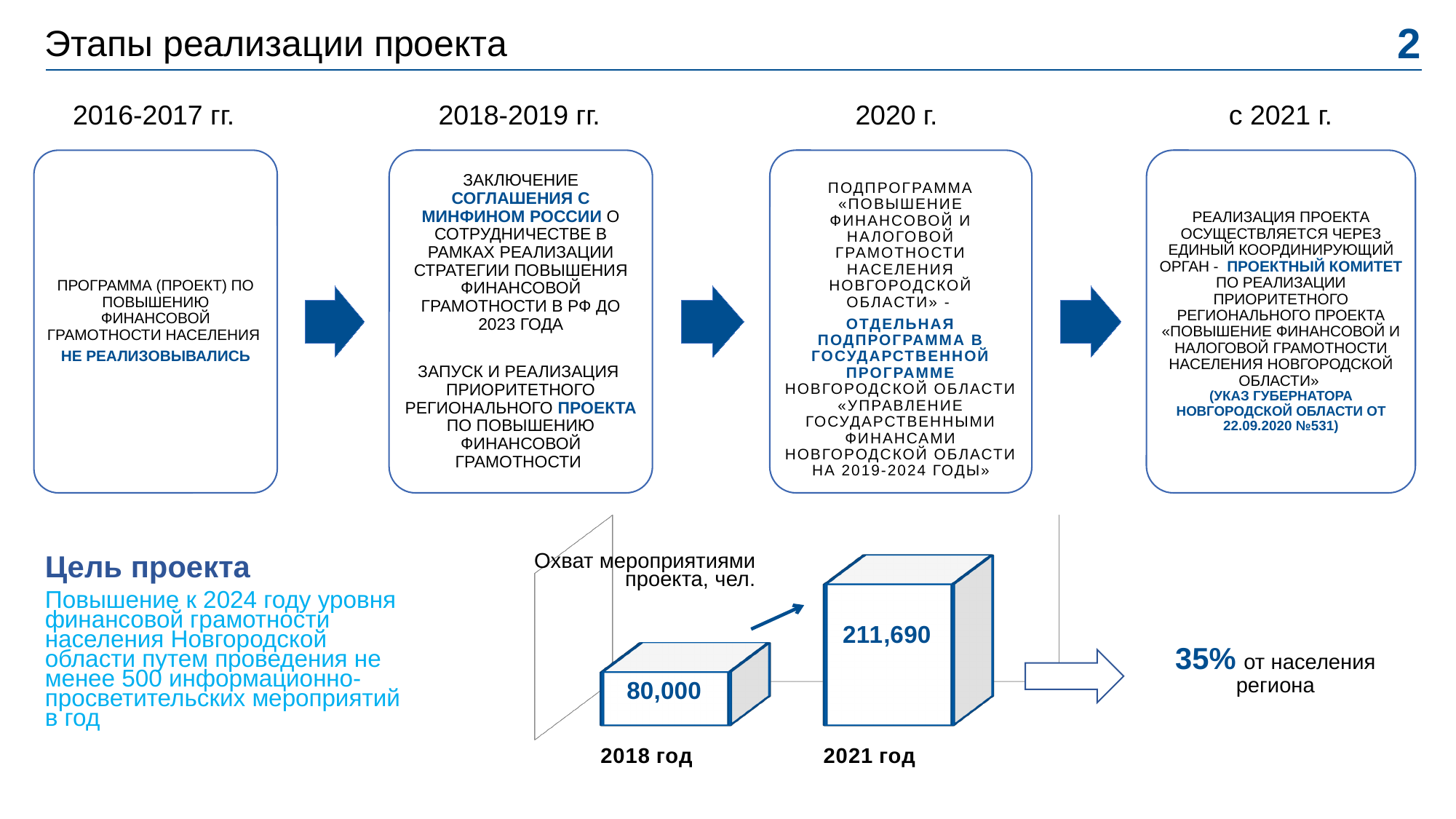
What is the value for 2018 год in the chart 'Охват мероприятиями проекта, чел.'? 80,000 Which year has the lowest value in the chart 'Охват мероприятиями проекта, чел.'? 2018 год What is the title of the chart at the bottom of the slide? Охват мероприятиями проекта, чел. How many categories (years) are plotted in the chart 'Охват мероприятиями проекта, чел.'? 2 What is the difference between the 2021 год and 2018 год values in the chart 'Охват мероприятиями проекта, чел.'? 131,690 Do the values in the chart 'Охват мероприятиями проекта, чел.' rise or fall from 2018 год to 2021 год? rise Which year has the highest value in the chart 'Охват мероприятиями проекта, чел.'? 2021 год What is the value for 2021 год in the chart 'Охват мероприятиями проекта, чел.'? 211,690 In the chart 'Охват мероприятиями проекта, чел.', which is larger: the value for 2018 год or for 2021 год? 2021 год What kind of chart is 'Охват мероприятиями проекта, чел.'? bar chart What percentage of the region's population is indicated next to the chart 'Охват мероприятиями проекта, чел.'? 35%